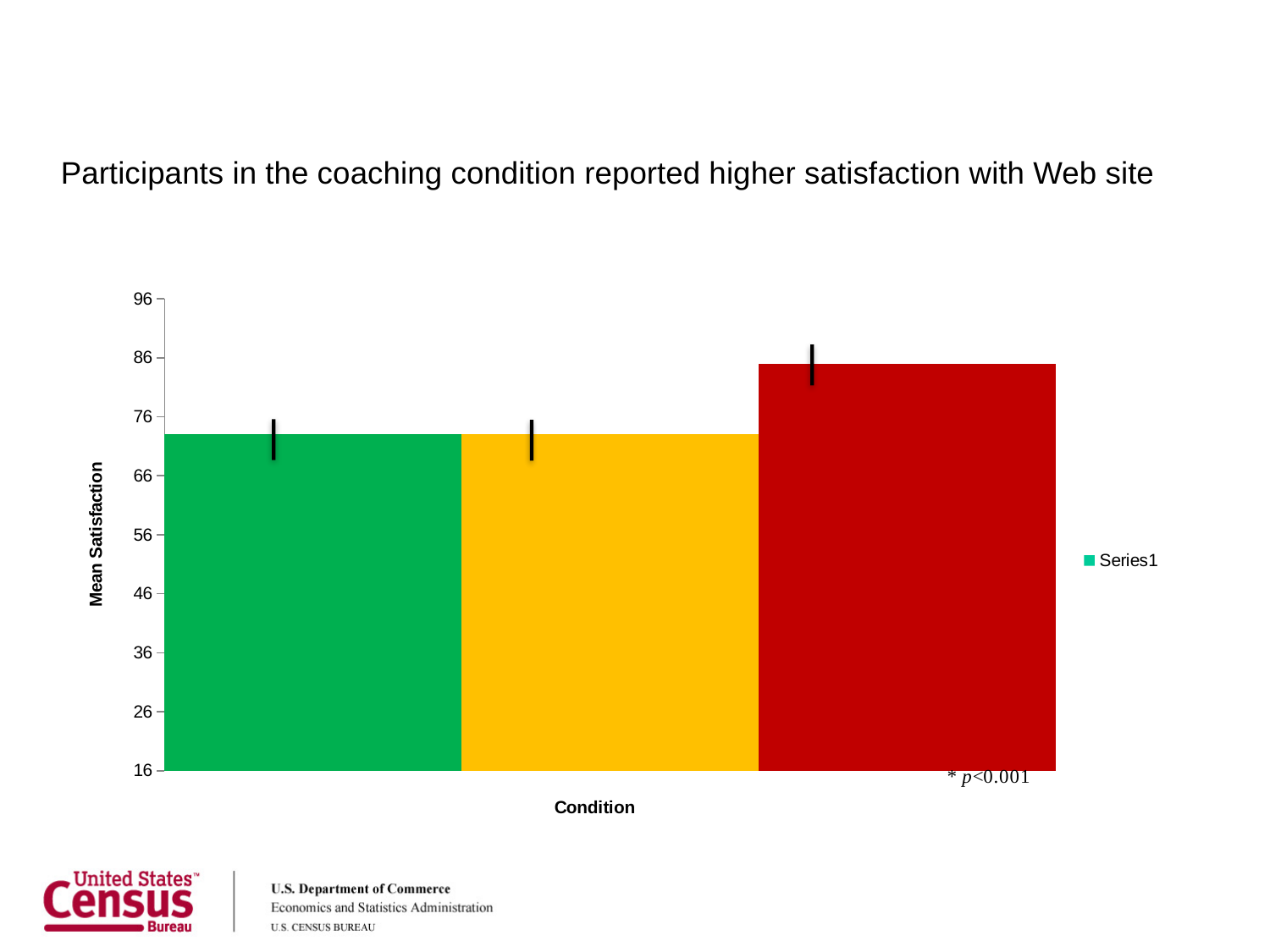
What kind of chart is shown on the slide? bar chart How many bars are plotted in the chart? 3 Is the value for the middle (yellow) bar greater or less than 66? greater Which is larger, the value of the rightmost (red) bar or the leftmost (green) bar? rightmost (red) bar What is the title of the vertical axis? Mean Satisfaction What is the title of the horizontal axis? Condition How many series does the legend list? 1 Is the value for the rightmost (red) bar greater or less than 76? greater Is the value for the leftmost (green) bar greater or less than 76? less Which bar is the highest: the leftmost (green), middle (yellow), or rightmost (red)? rightmost (red)